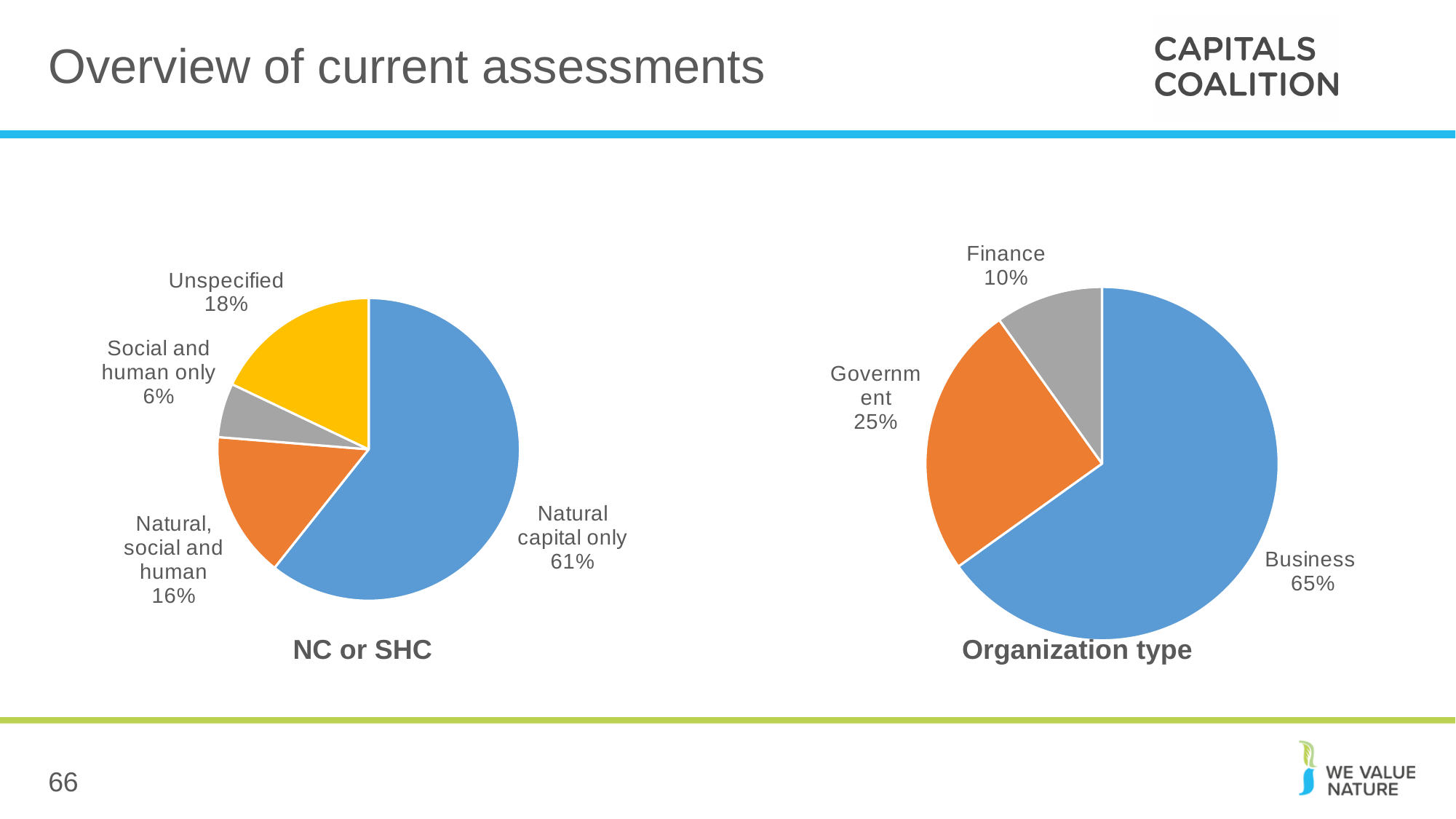
In the 'NC or SHC' pie chart, which category has the smallest slice? Social and human only In the 'NC or SHC' pie chart, how many slices does the pie have? 4 In the 'NC or SHC' pie chart, which is larger: 'Natural, social and human' or 'Social and human only'? Natural, social and human In the 'Organization type' pie chart, what share is labelled for 'Government'? 25% In the 'Organization type' pie chart, what share is labelled for 'Finance'? 10% In the 'NC or SHC' pie chart, what share is labelled for 'Natural capital only'? 61% What type of chart is used for 'Organization type'? Pie chart In the 'Organization type' pie chart, how many categories are shown? 3 In the 'Organization type' pie chart, which category has the largest slice? Business In the 'NC or SHC' pie chart, what is the difference in percentage points between 'Unspecified' and 'Natural, social and human'? 2 In the 'Organization type' pie chart, what is the difference in percentage points between 'Business' and 'Government'? 40 In the 'NC or SHC' pie chart, what share is labelled for 'Unspecified'? 18%